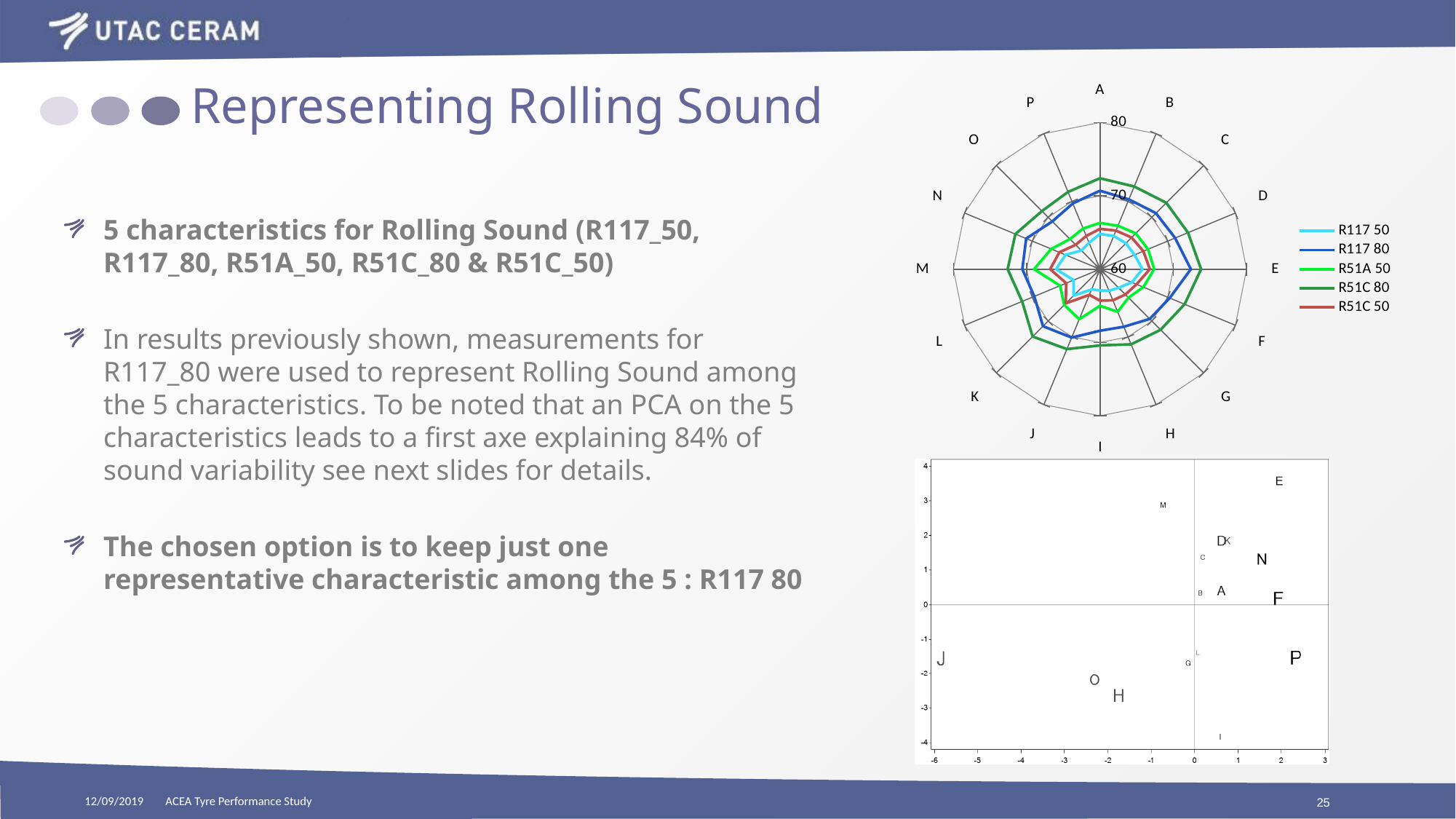
What kind of chart is the chart in the bottom right of the slide? scatter chart In the radar chart, which series is drawn in red? R51C 50 In the radar chart, how many categories are plotted around the axis? 16 In the scatter chart, which point has the highest vertical value? E In the scatter chart, is the horizontal value of point J greater or less than -5? less In the radar chart, which series forms the outermost line? R51C 80 In the radar chart, is the value of R117 50 at category A greater or less than 70? less In the radar chart, how many series does the legend list? 5 In the radar chart, is the value of R51C 80 at category A greater or less than 70? greater In the radar chart, which is larger at category E: R117 80 or R117 50? R117 80 What kind of chart is the chart in the top right of the slide? radar chart In the scatter chart, which point has the lowest vertical value? I